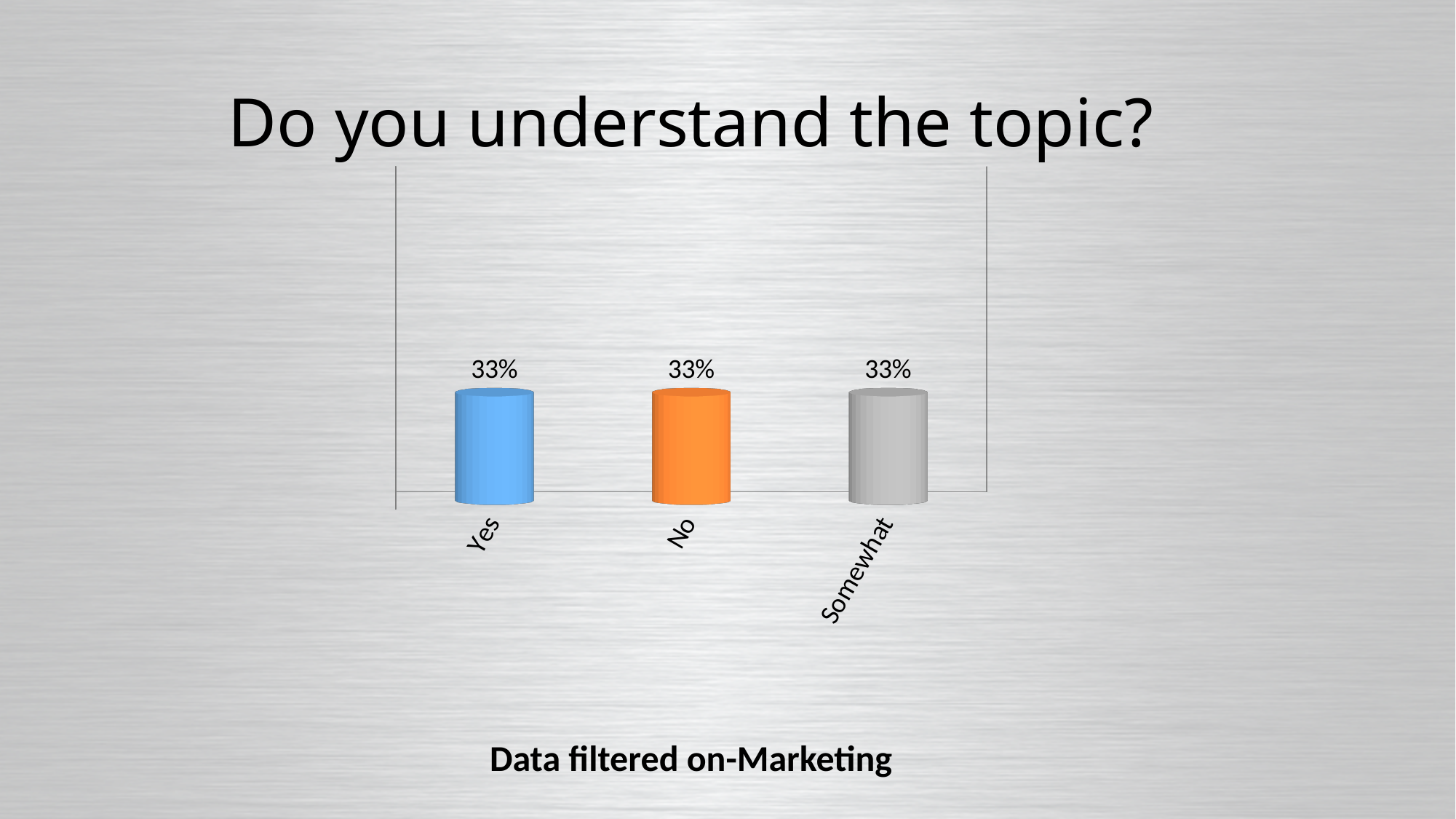
What is the total of the three values shown? 99% What is the value for Somewhat? 33% Is the value for Somewhat larger than, smaller than, or equal to the value for Yes? Equal What is the value for Yes? 33% What is the difference between the values for Yes and No? 0% What is the title of the chart? Do you understand the topic? Do the values rise, fall, or stay the same across the categories from Yes to Somewhat? Stay the same How many categories are shown on the x axis? 3 What kind of chart is shown on the slide? Bar chart What colour is the bar for No? Orange What is the value for No? 33%